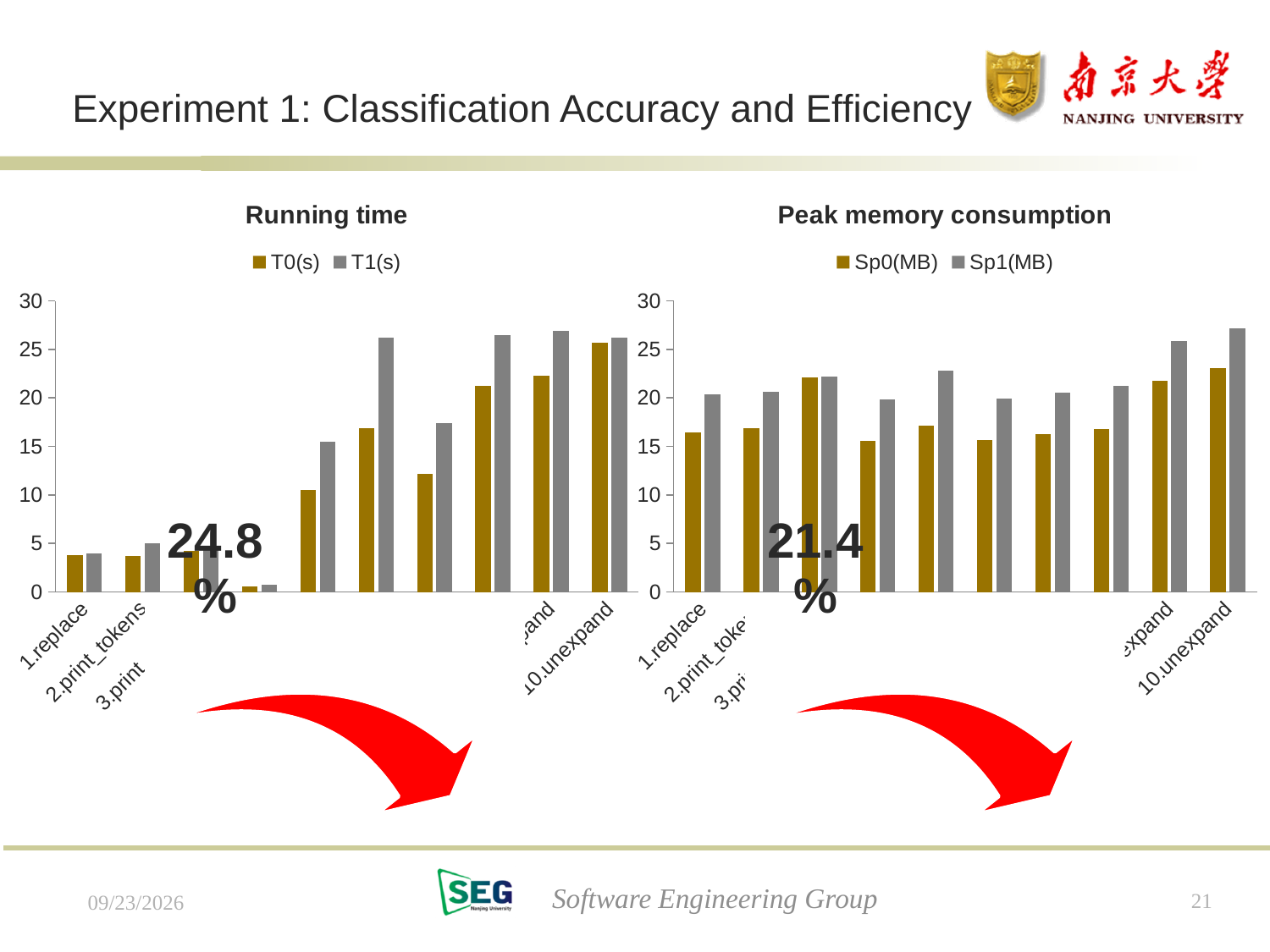
In the Running time chart, is the T0(s) value for 1.replace greater or less than 5? less In the Peak memory consumption chart, is the Sp1(MB) value for 10.unexpand greater or less than 25? greater In the Running time chart, is the T1(s) value for 10.unexpand greater or less than 20? greater What is the title of the chart on the right side of the slide? Peak memory consumption What are the two series named in the legend of the Peak memory consumption chart? Sp0(MB) and Sp1(MB) How many categories are plotted in the Peak memory consumption chart? 10 In the Peak memory consumption chart, which is larger for 1.replace, Sp0(MB) or Sp1(MB)? Sp1(MB) In the Running time chart, which category has the lowest T0(s) value, 1.replace or 10.unexpand? 1.replace What kind of chart is the Running time chart? bar chart In the Running time chart, which is larger for 10.unexpand, T0(s) or T1(s)? T1(s) How many series does the legend of the Running time chart list? 2